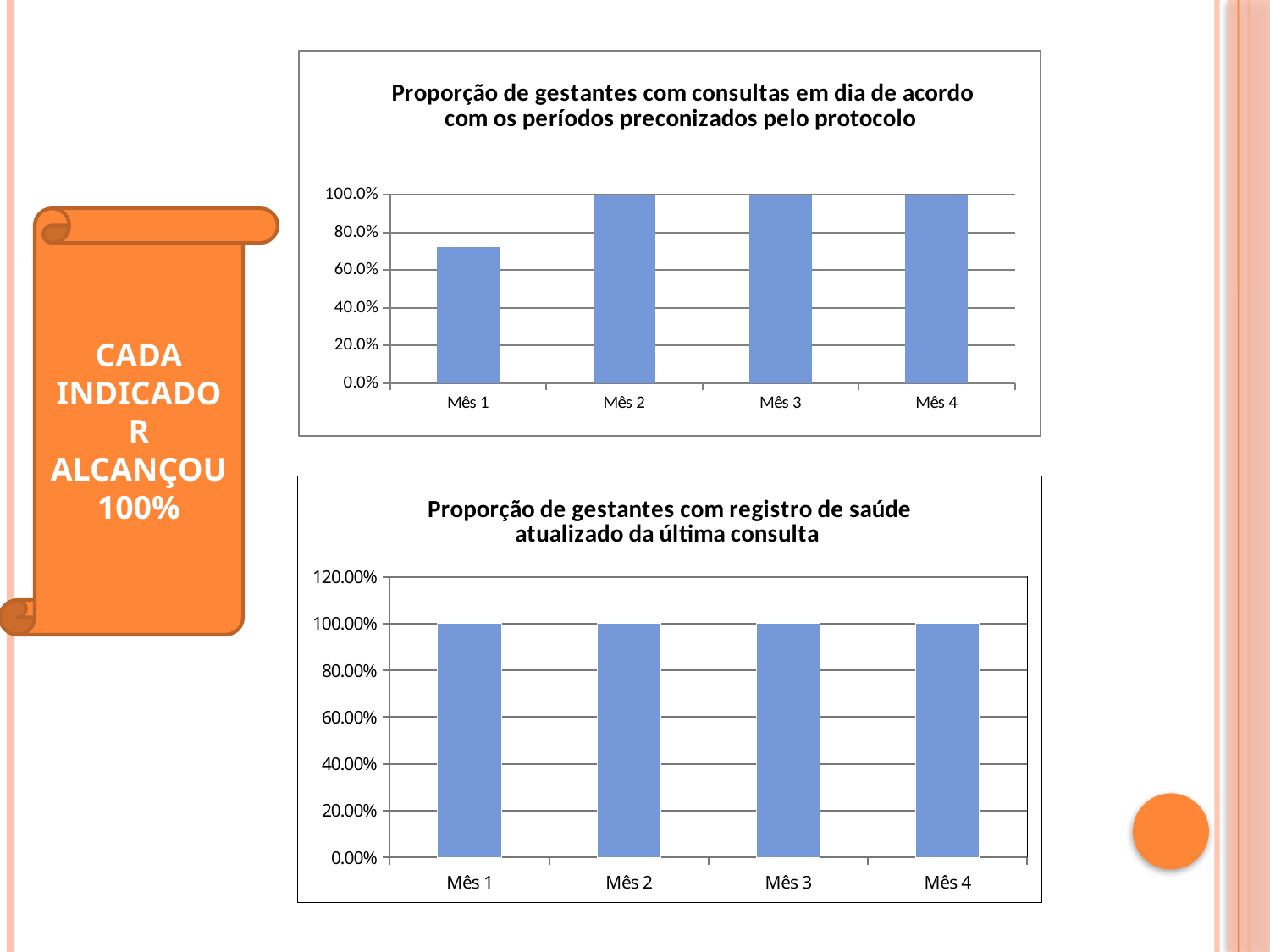
In the top chart (Proporção de gestantes com consultas em dia), does the value rise or fall from Mês 1 to Mês 2? rise In the top chart (Proporção de gestantes com consultas em dia), what is the value for Mês 2? 100.0% In the top chart (Proporção de gestantes com consultas em dia), which is larger, the value for Mês 1 or the value for Mês 2? Mês 2 What is the highest value shown on the y axis of the bottom chart (Proporção de gestantes com registro de saúde atualizado)? 120.00% In the top chart (Proporção de gestantes com consultas em dia), which month has the lowest value? Mês 1 In the bottom chart (Proporção de gestantes com registro de saúde atualizado), what is the value for Mês 4? 100.00% How many months are shown on the x axis of the top chart (Proporção de gestantes com consultas em dia)? 4 In the top chart (Proporção de gestantes com consultas em dia), is the value for Mês 1 greater or less than 60.0%? greater In the bottom chart (Proporção de gestantes com registro de saúde atualizado), what is the value for Mês 1? 100.00% In the bottom chart (Proporção de gestantes com registro de saúde atualizado), what is the difference between the values for Mês 2 and Mês 3? 0.00% What kind of chart is the bottom chart (Proporção de gestantes com registro de saúde atualizado)? bar chart In the top chart (Proporção de gestantes com consultas em dia), is the value for Mês 1 greater or less than 80.0%? less